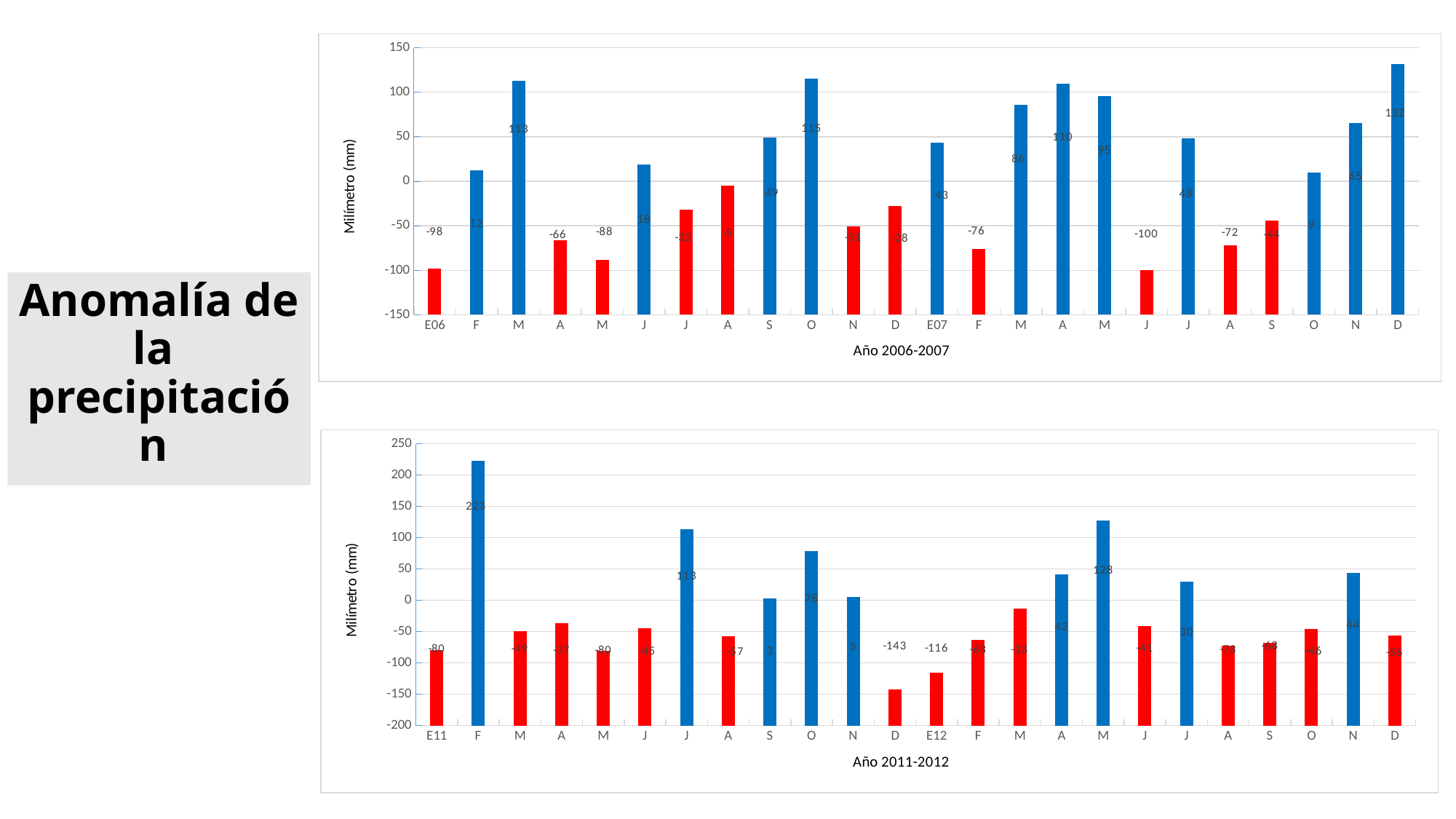
In the bottom chart (Año 2011-2012), which is larger, the value for E11 or the value for E12? E11 In the bottom chart (Año 2011-2012), what is the value for E12? -116 In the bottom chart (Año 2011-2012), which month has the lowest value? D (December 2011) In the top chart (Año 2006-2007), what is the difference between the values for E07 and E06? 141 What kind of chart is the top chart (Año 2006-2007)? Bar chart In the top chart (Año 2006-2007), which month has the highest value? D (December 2007, the last bar) In the bottom chart (Año 2011-2012), is the value for the first F bar greater or less than 200? greater In the top chart (Año 2006-2007), how many bars are plotted? 24 In the top chart (Año 2006-2007), what is the value for E06? -98 In the bottom chart (Año 2011-2012), what is the value for E11? -80 In the top chart (Año 2006-2007), what is the value for E07? 43 In the bottom chart (Año 2011-2012), which month has the highest value? F (February 2011)